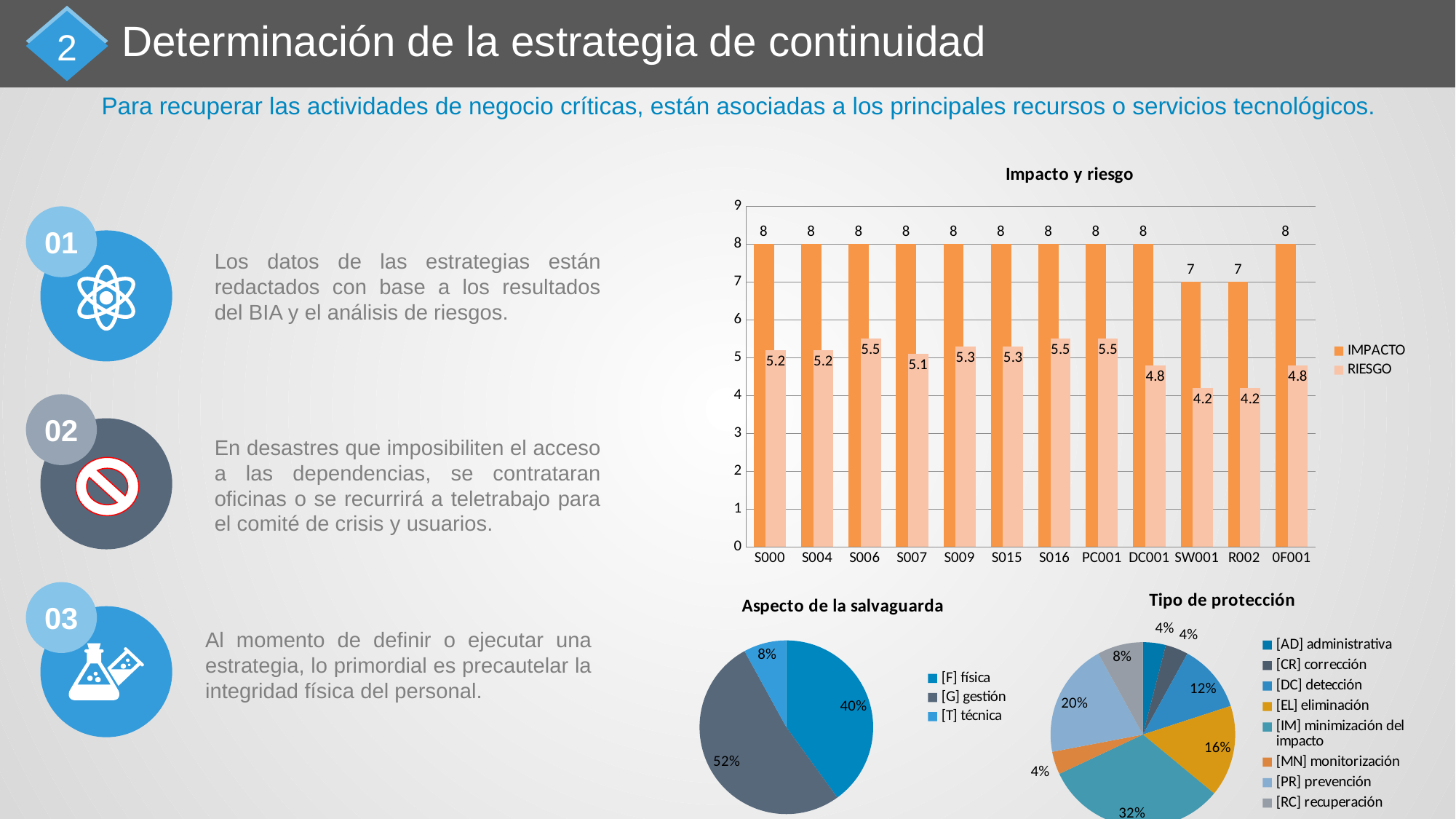
How many series does the legend of the 'Impacto y riesgo' chart list? 2 In the 'Aspecto de la salvaguarda' pie chart, what share does [G] gestión have? 52% In the 'Impacto y riesgo' chart, what is the IMPACTO value for SW001? 7 In the 'Impacto y riesgo' chart, is the RIESGO value for S006 larger or smaller than the RIESGO value for R002? larger How many categories are shown on the x axis of the 'Impacto y riesgo' chart? 12 In the 'Tipo de protección' pie chart, what share does [IM] minimización del impacto have? 32% In the 'Impacto y riesgo' chart, which category has the lowest RIESGO value? SW001 and R002 (4.2) In the 'Impacto y riesgo' chart, what is the difference between the IMPACTO and RIESGO values for DC001? 3.2 In the 'Impacto y riesgo' chart, what is the RIESGO value for S007? 5.1 What type of chart is 'Impacto y riesgo'? bar chart In the 'Aspecto de la salvaguarda' pie chart, which slice is the smallest? [T] técnica How many entries does the legend of the 'Tipo de protección' pie chart list? 8